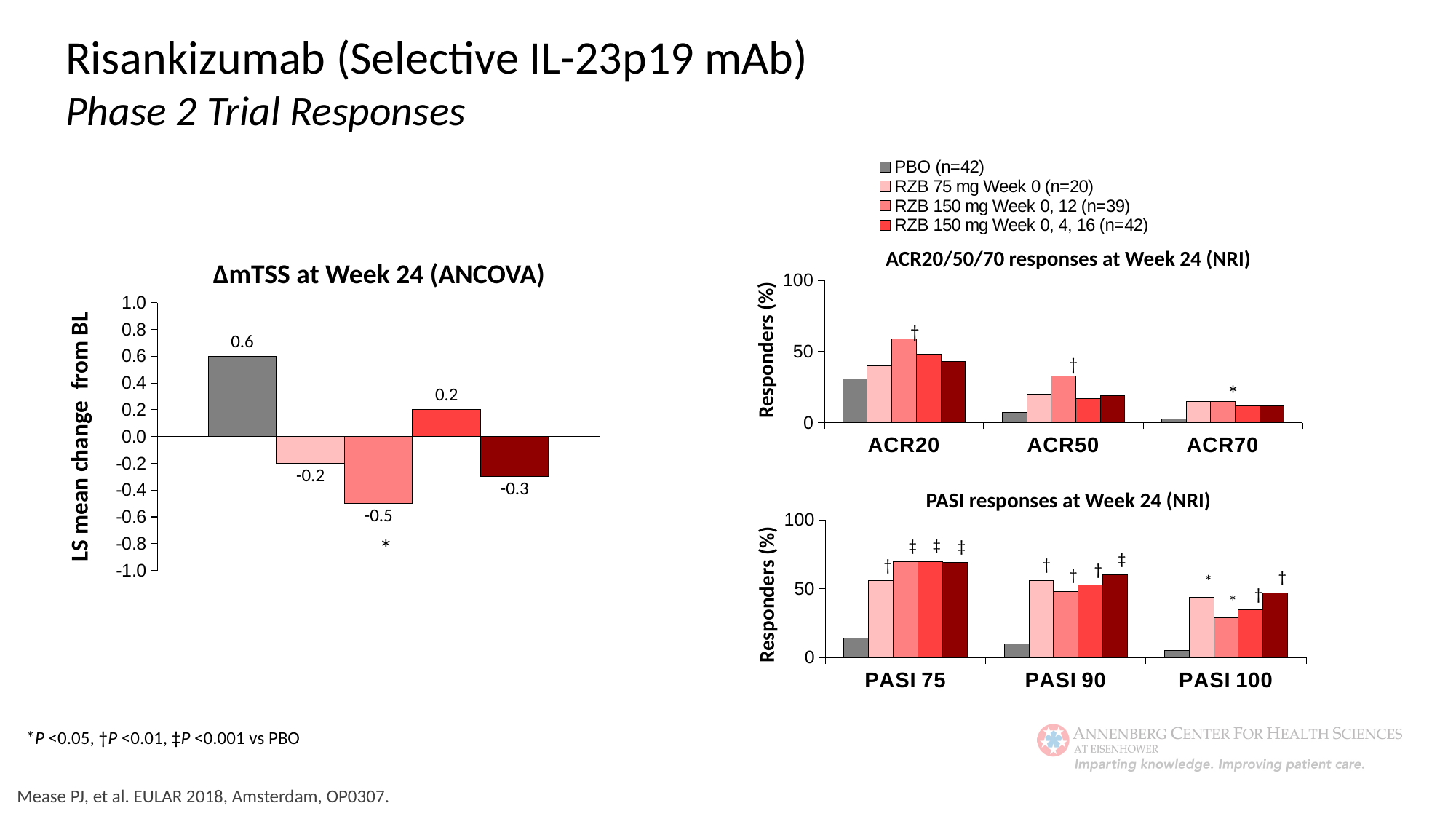
What kind of chart is the ΔmTSS at Week 24 (ANCOVA) chart? bar chart In the ACR20/50/70 responses at Week 24 (NRI) chart, is the RZB 75 mg Week 0 value larger for ACR20 or for ACR50? ACR20 In the ACR20/50/70 responses at Week 24 (NRI) chart, is the PBO value for ACR20 greater or less than 50? less In the ΔmTSS at Week 24 (ANCOVA) chart, what is the highest value shown? 0.6 In the ΔmTSS at Week 24 (ANCOVA) chart, what is the lowest value shown? -0.5 In the ΔmTSS at Week 24 (ANCOVA) chart, what is the difference between the highest value (0.6) and the lowest value (-0.5)? 1.1 In the PASI responses at Week 24 (NRI) chart, is the PBO value for PASI 75 greater or less than 50? less How many bars are plotted in the ΔmTSS at Week 24 (ANCOVA) chart? 5 In the PASI responses at Week 24 (NRI) chart, which category has the highest value for RZB 150 mg Week 0, 4, 16? PASI 75 In the ΔmTSS at Week 24 (ANCOVA) chart, what is the value of the last (dark red) bar? -0.3 How many series does the legend above the ACR20/50/70 responses chart list? 4 How many categories are shown on the x axis of the ACR20/50/70 responses at Week 24 (NRI) chart? 3